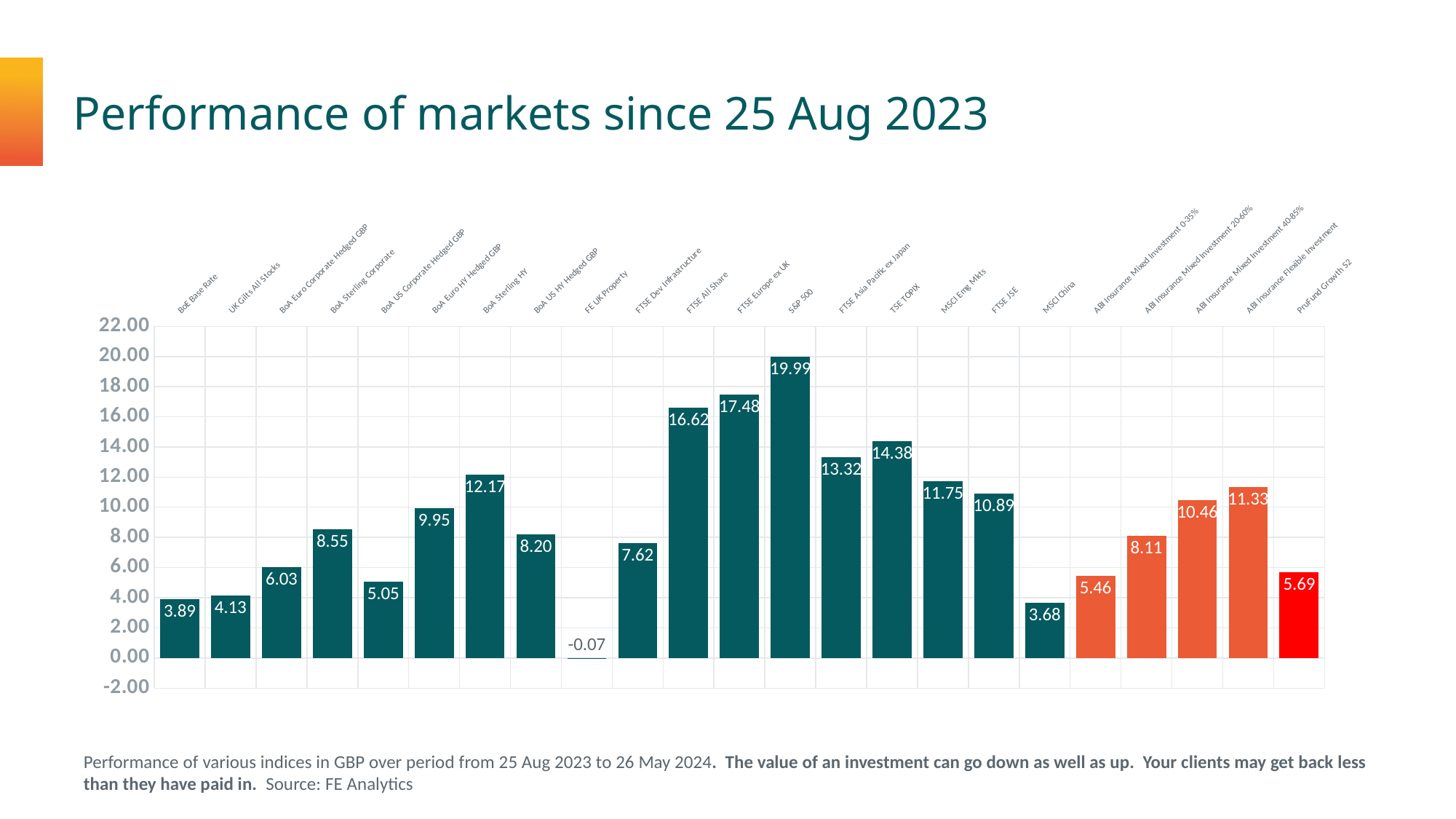
What is the title of the chart on the slide? Performance of markets since 25 Aug 2023 Is the value for BoA Sterling HY greater or less than 10.00? greater Which category has the lowest value? FE UK Property What kind of chart is shown on the slide? Bar chart What is the value shown for S&P 500? 19.99 What is the value shown for PruFund Growth S2? 5.69 What is the value shown for FE UK Property? -0.07 What is the value shown for MSCI China? 3.68 How many categories are plotted on the chart? 23 What is the difference between the values for FTSE Europe ex UK and FTSE All Share? 0.86 Which category has the highest value? S&P 500 Which is larger, the value for TSE TOPIX or the value for FTSE Asia Pacific ex Japan? TSE TOPIX